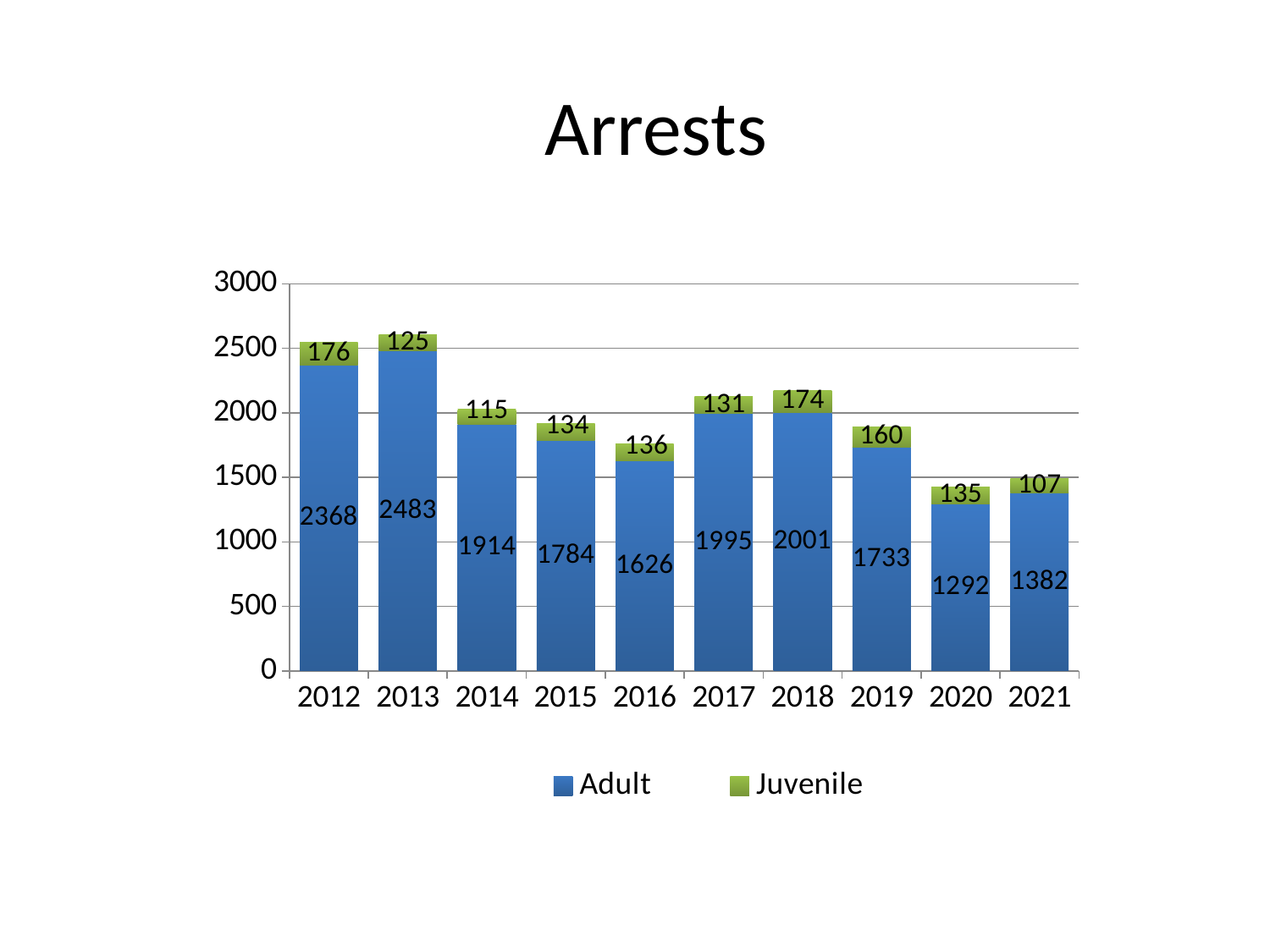
How many years are shown on the x axis? 10 How many series does the legend list? 2 Which is larger, the Juvenile value for 2012 or for 2018? 2012 What kind of chart is shown? Stacked bar chart What is the title of the chart? Arrests What is the total of the stacked bar for 2021? 1489 What is the difference between the Adult values for 2012 and 2013? 115 What is the Adult value for 2013? 2483 Which year has the highest Adult value? 2013 Which year has the lowest Juvenile value? 2021 What is the Juvenile value for 2019? 160 Which year has the lowest Adult value? 2020